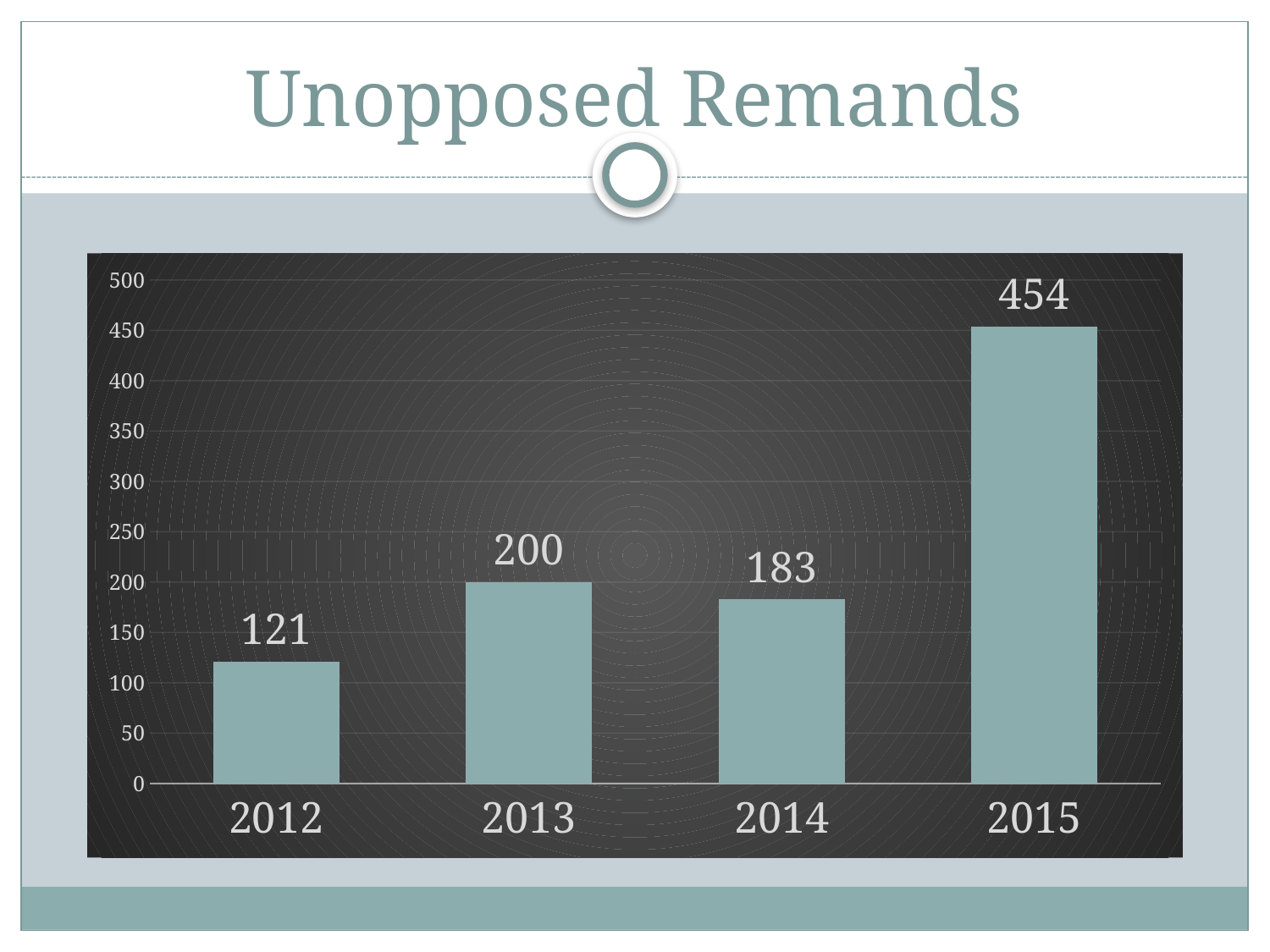
What is the value for 2015? 454 Which is larger, the value for 2013 or the value for 2014? 2013 What is the difference between the values for 2013 and 2012? 79 What is the value for 2013? 200 Which year has the lowest value? 2012 Is the value for 2015 greater or less than 400? greater What is the value for 2014? 183 How many years are shown on the chart? 4 What is the difference between the values for 2015 and 2014? 271 Which year has the highest value? 2015 What kind of chart is shown on the slide? bar chart What is the value for 2012? 121